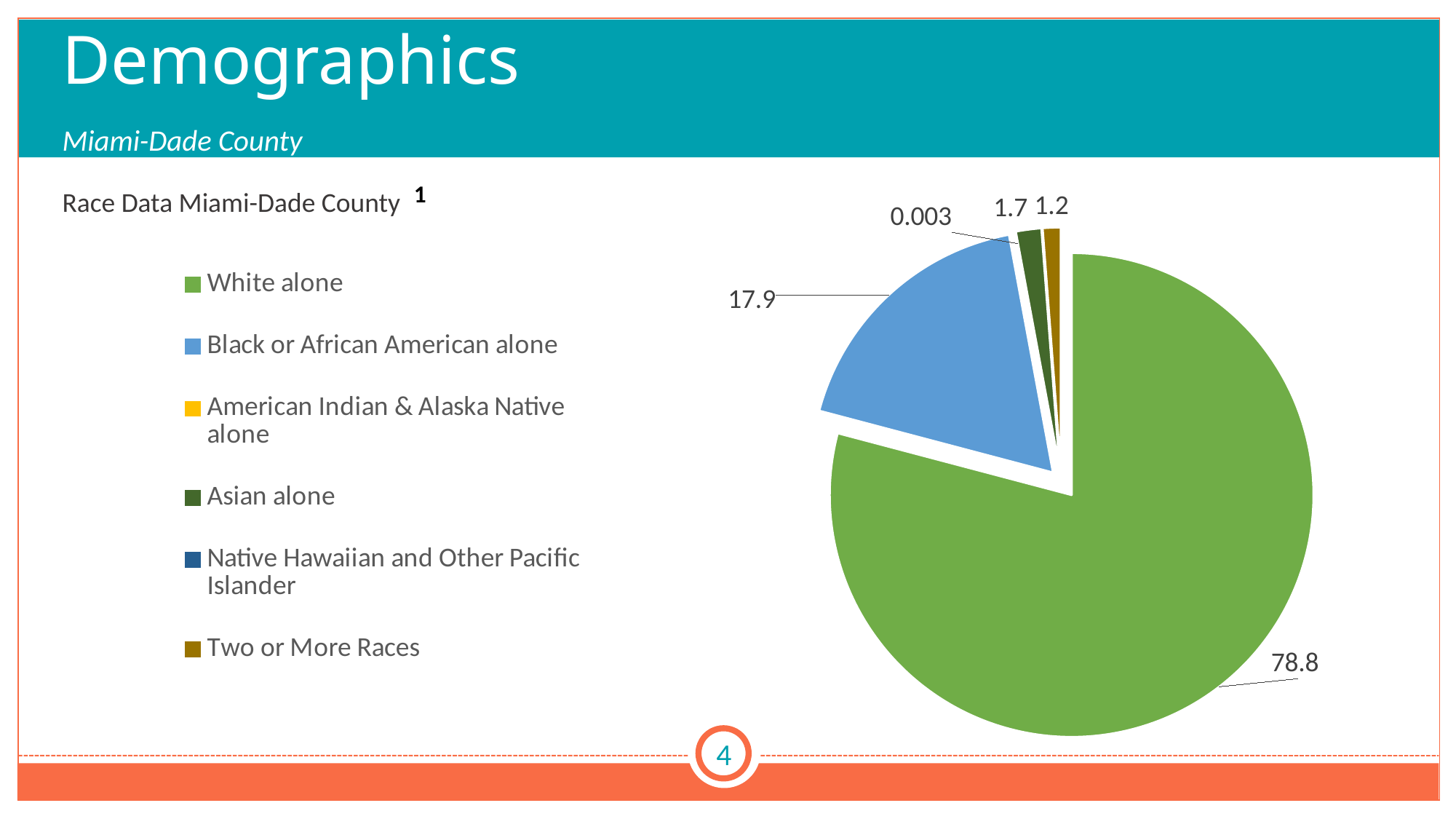
What is the value labelled for the Two or More Races slice? 1.2 What is the difference between the White alone value and the Black or African American alone value? 60.9 What is the smallest value labelled on the pie chart? 0.003 What is the value labelled for the Asian alone slice? 1.7 What colour represents White alone in the pie chart? green Which category has the largest slice of the pie? White alone What type of chart is shown on the slide? pie chart Which is larger, the Asian alone slice or the Two or More Races slice? Asian alone What is the value labelled for the Black or African American alone slice? 17.9 How many categories does the legend list? 6 What is the title of the chart? Race Data Miami-Dade County What is the value labelled for the White alone slice? 78.8